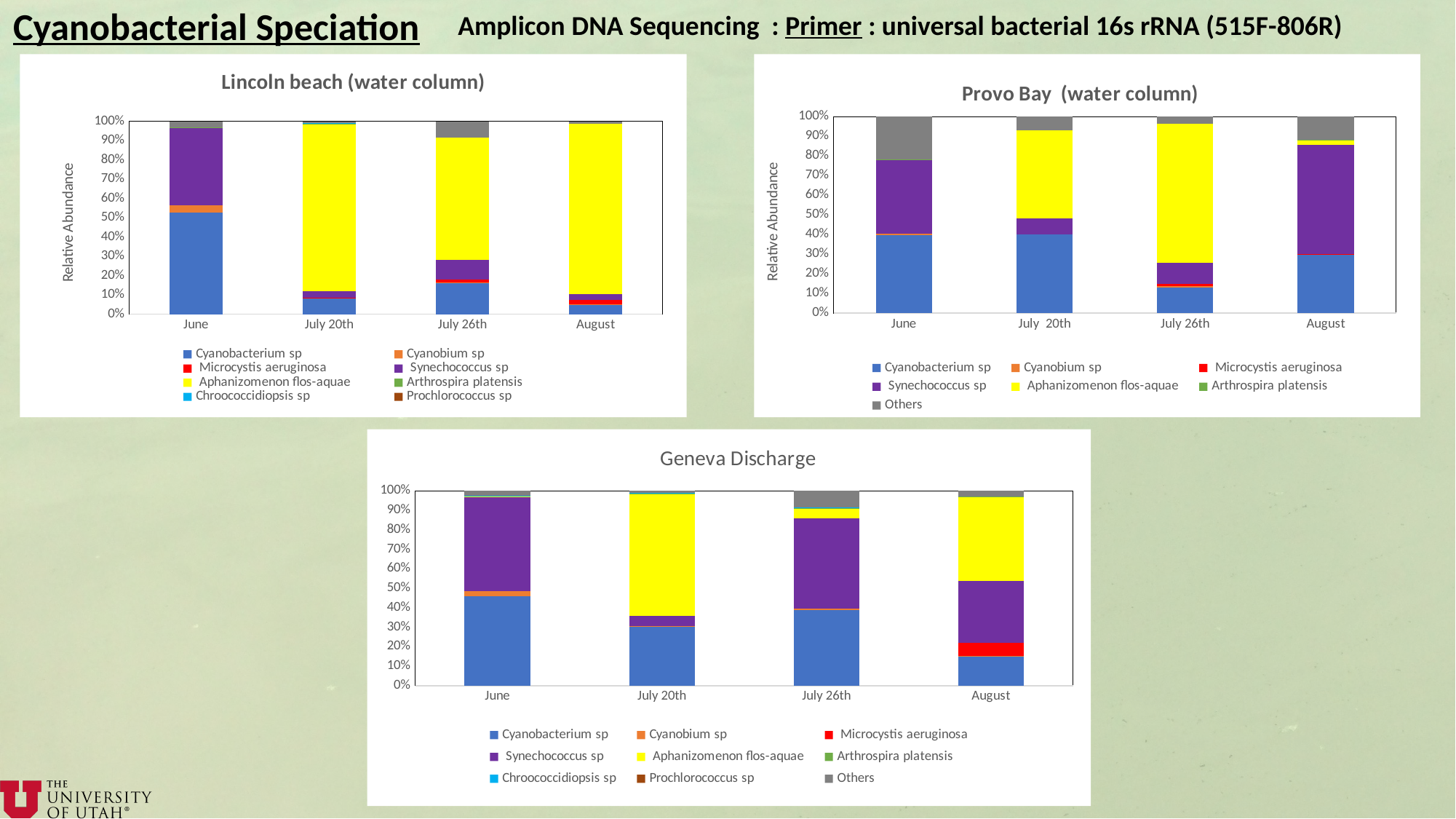
How many sampling dates are shown on the x axis of the Provo Bay (water column) chart? 4 What kind of chart is the Lincoln beach (water column) chart? Stacked bar chart In the Geneva Discharge chart, which date has the larger relative abundance of Synechococcus sp, June or July 20th? June In the Lincoln beach (water column) chart, is the relative abundance of Cyanobacterium sp in June greater or less than 50%? greater In the Provo Bay (water column) chart, is the relative abundance of Synechococcus sp in August greater or less than 50%? greater In the Geneva Discharge chart, is the relative abundance of Cyanobacterium sp in June greater or less than 50%? less How many series does the legend of the Lincoln beach (water column) chart list? 8 What is the y-axis label of the Lincoln beach (water column) chart? Relative Abundance How many series does the legend of the Provo Bay (water column) chart list? 7 In the Lincoln beach (water column) chart, which date has the larger relative abundance of Cyanobacterium sp, June or August? June How many series does the legend of the Geneva Discharge chart list? 9 What is the total height of the June stacked bar in the Provo Bay (water column) chart? 100%